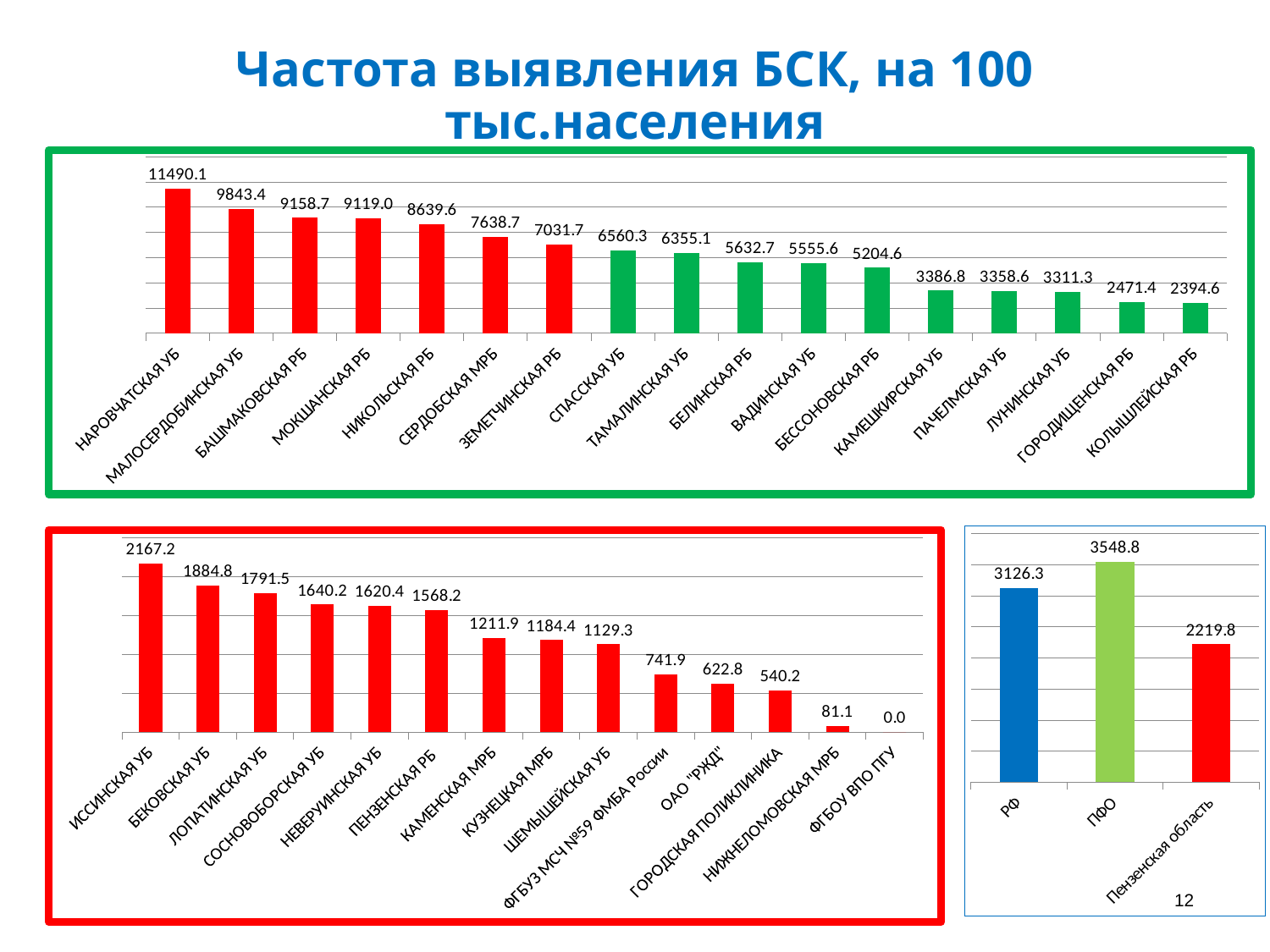
In the top chart, what is the value for НАРОВЧАТСКАЯ УБ? 11490.1 In the top chart, which category has the lowest value? КОЛЫШЛЕЙСКАЯ РБ In the bottom-left chart, which category has the highest value? ИССИНСКАЯ УБ In the bottom-right chart, what is the value for ПФО? 3548.8 What kind of chart is the bottom-right chart? bar chart In the top chart, what is the difference between the values for СПАССКАЯ УБ and ТАМАЛИНСКАЯ УБ? 205.2 In the top chart, how many categories are plotted? 17 In the bottom-left chart, how many categories are plotted? 14 In the bottom-left chart, what is the value for ФГБОУ ВПО ПГУ? 0.0 In the bottom-right chart, what is the difference between the values for РФ and Пензенская область? 906.5 In the bottom-left chart, what is the value for КАМЕНСКАЯ МРБ? 1211.9 In the top chart, which is larger, the value for БЕЛИНСКАЯ РБ or the value for ВАДИНСКАЯ УБ? БЕЛИНСКАЯ РБ